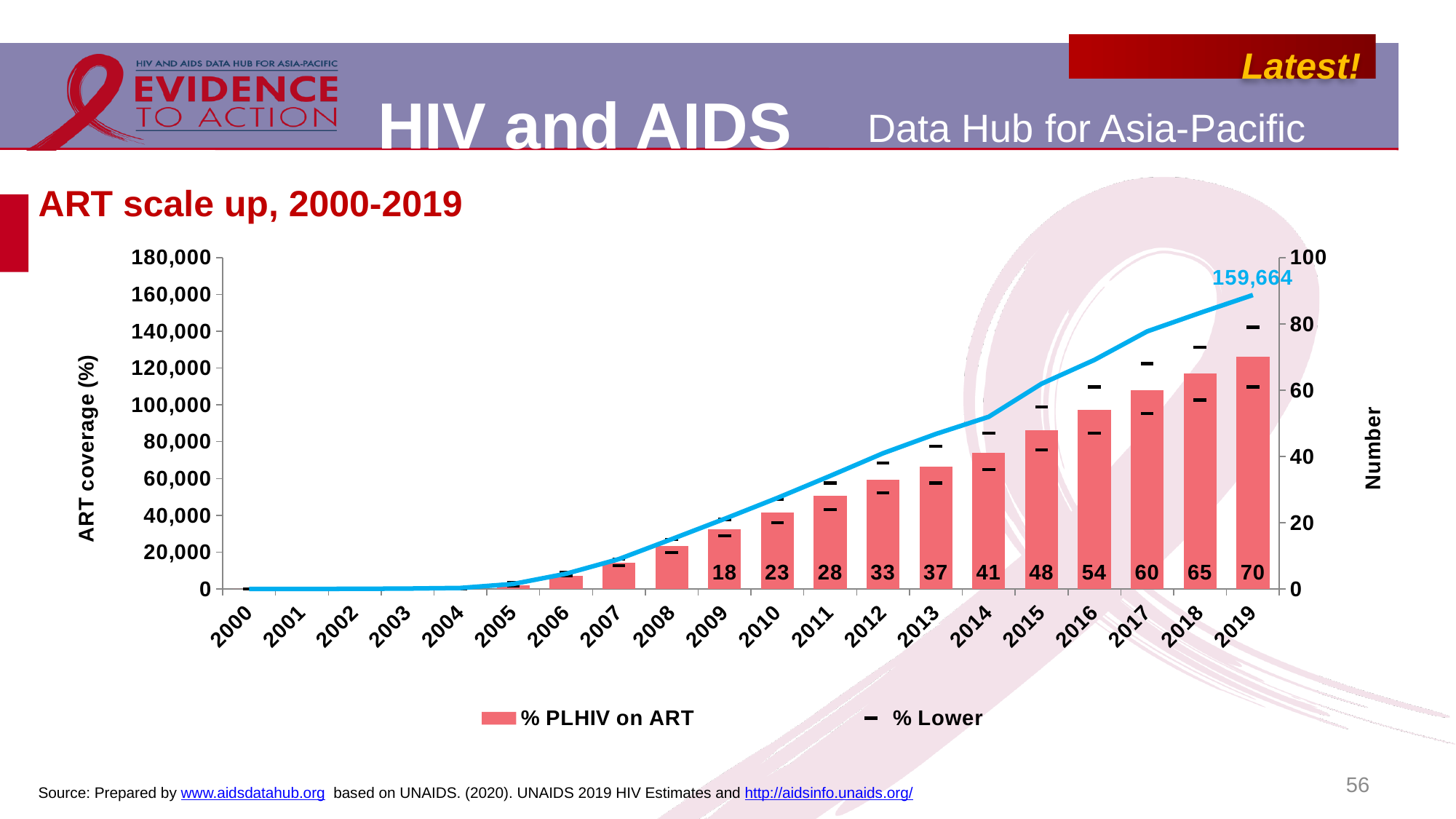
Is the number on the blue line for 2014 greater or less than 80,000? greater What is the % PLHIV on ART value for 2014? 41 What is the difference between the % PLHIV on ART values for 2019 and 2009? 52 Which is larger, the % PLHIV on ART value for 2012 or for 2017? 2017 What number is labelled on the blue line for 2019? 159,664 What is the % PLHIV on ART value for 2019? 70 What is the % PLHIV on ART value for 2009? 18 What is the title of the chart? ART scale up, 2000-2019 How many years are shown on the x axis? 20 Do the % PLHIV on ART bars rise or fall from 2009 to 2019? rise Which year has the highest % PLHIV on ART bar? 2019 What is the difference between the % PLHIV on ART values for 2016 and 2015? 6